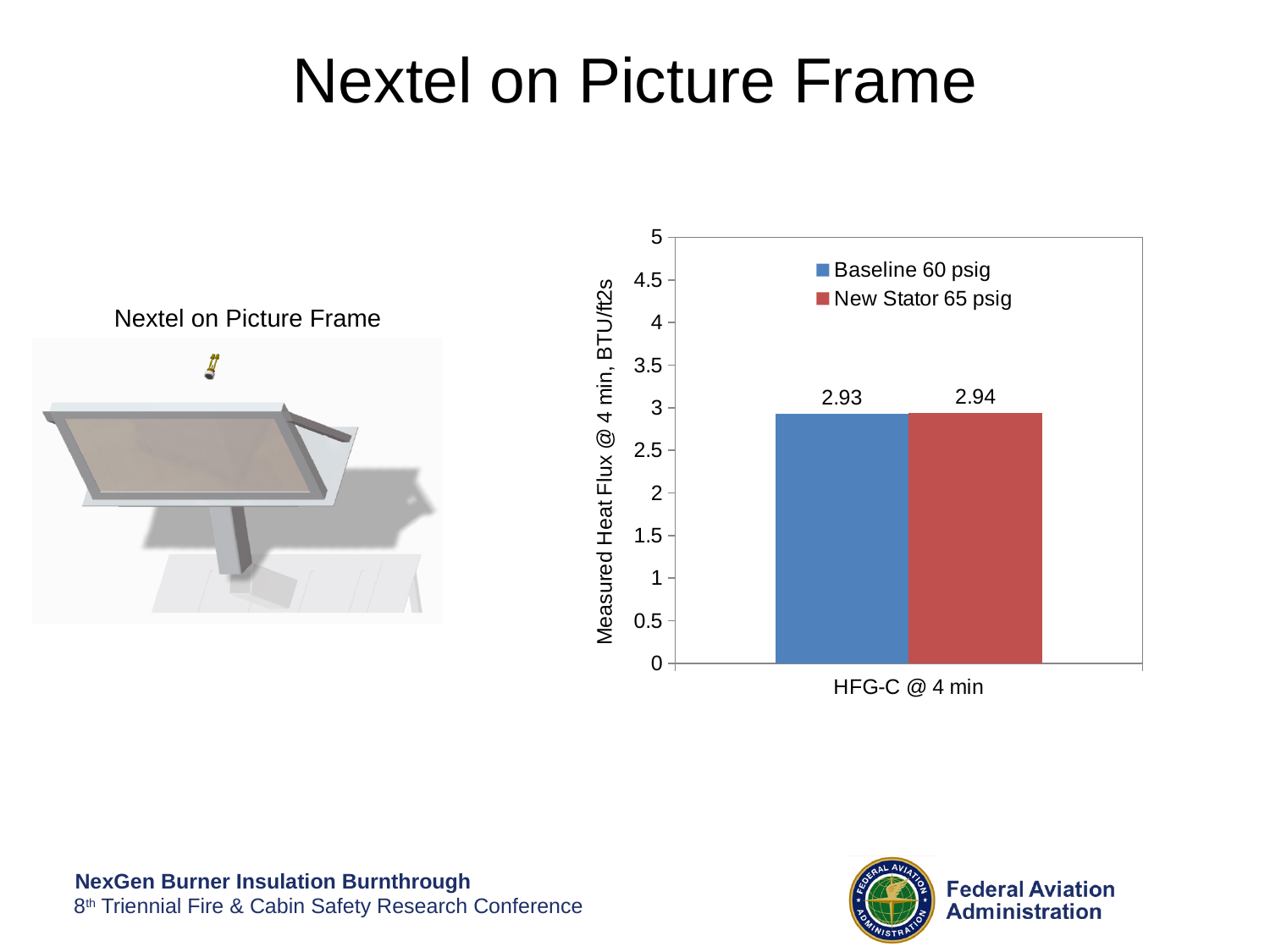
Is the value for New Stator 65 psig greater or less than 2.5? greater What is the y-axis label of the chart? Measured Heat Flux @ 4 min, BTU/ft2s How many series does the chart legend list? 2 How many categories are shown on the x axis of the chart? 1 What kind of chart is shown on the slide? bar chart What is the label of the category on the x axis? HFG-C @ 4 min What is the value for New Stator 65 psig at HFG-C @ 4 min? 2.94 Is the value for Baseline 60 psig greater or less than 3? less What is the difference between the New Stator 65 psig value and the Baseline 60 psig value? 0.01 Which series has the larger value at HFG-C @ 4 min, Baseline 60 psig or New Stator 65 psig? New Stator 65 psig What is the value for Baseline 60 psig at HFG-C @ 4 min? 2.93